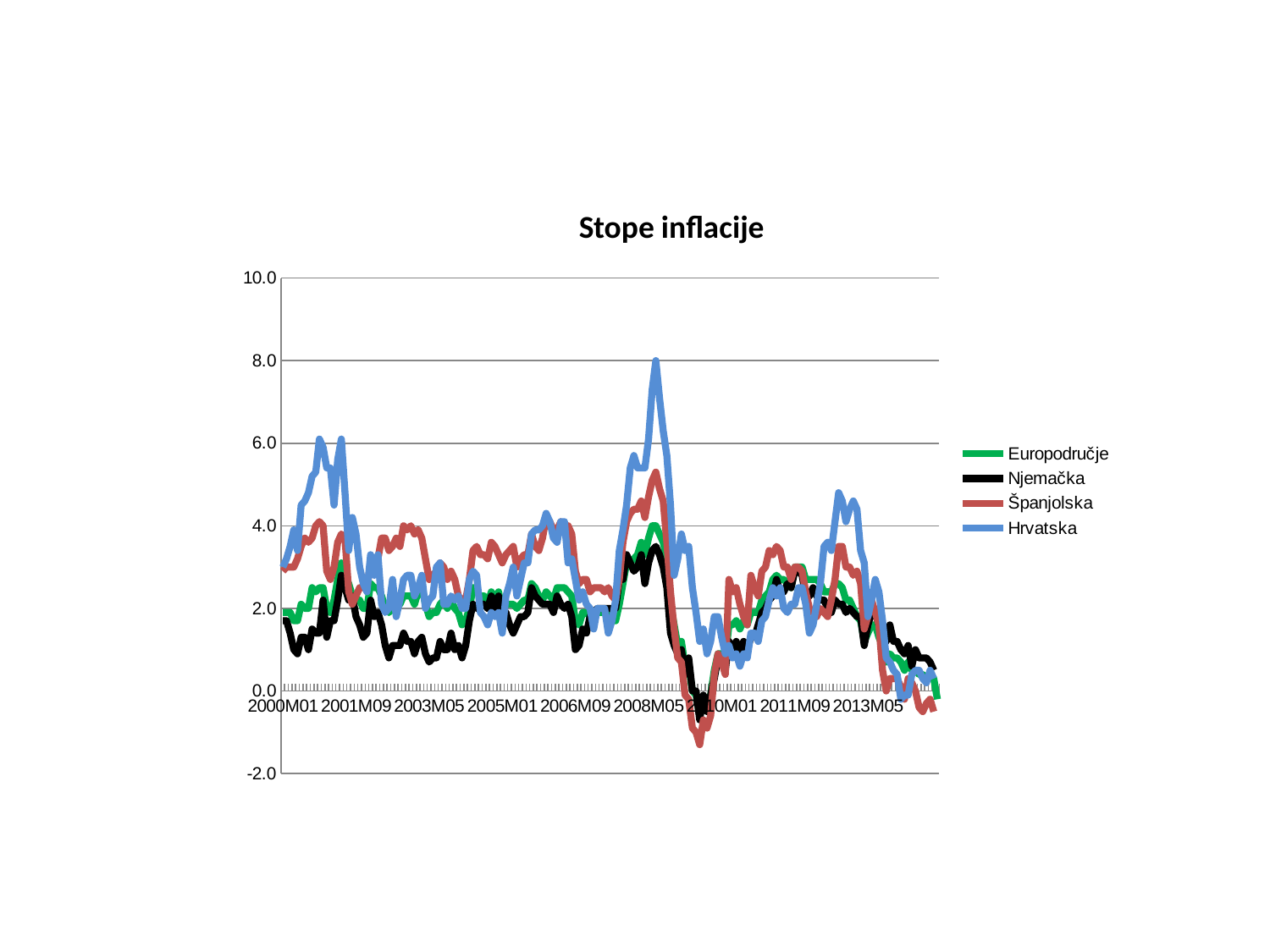
How many labels are shown on the horizontal axis? 9 Is the value for Njemačka at 2003M05 greater or less than 2.0? less Is the lowest value for Španjolska around 2009 greater or less than 0.0? less Which series reaches the lowest value on the chart? Španjolska Is the value for Hrvatska at 2000M01 greater or less than 2.0? greater How many series does the legend list? 4 Which colour represents Hrvatska in the chart? blue What is the highest value shown on the vertical axis? 10.0 Which series reaches the highest value on the chart? Hrvatska What kind of chart is shown on the slide? line chart What is the title of the chart? Stope inflacije